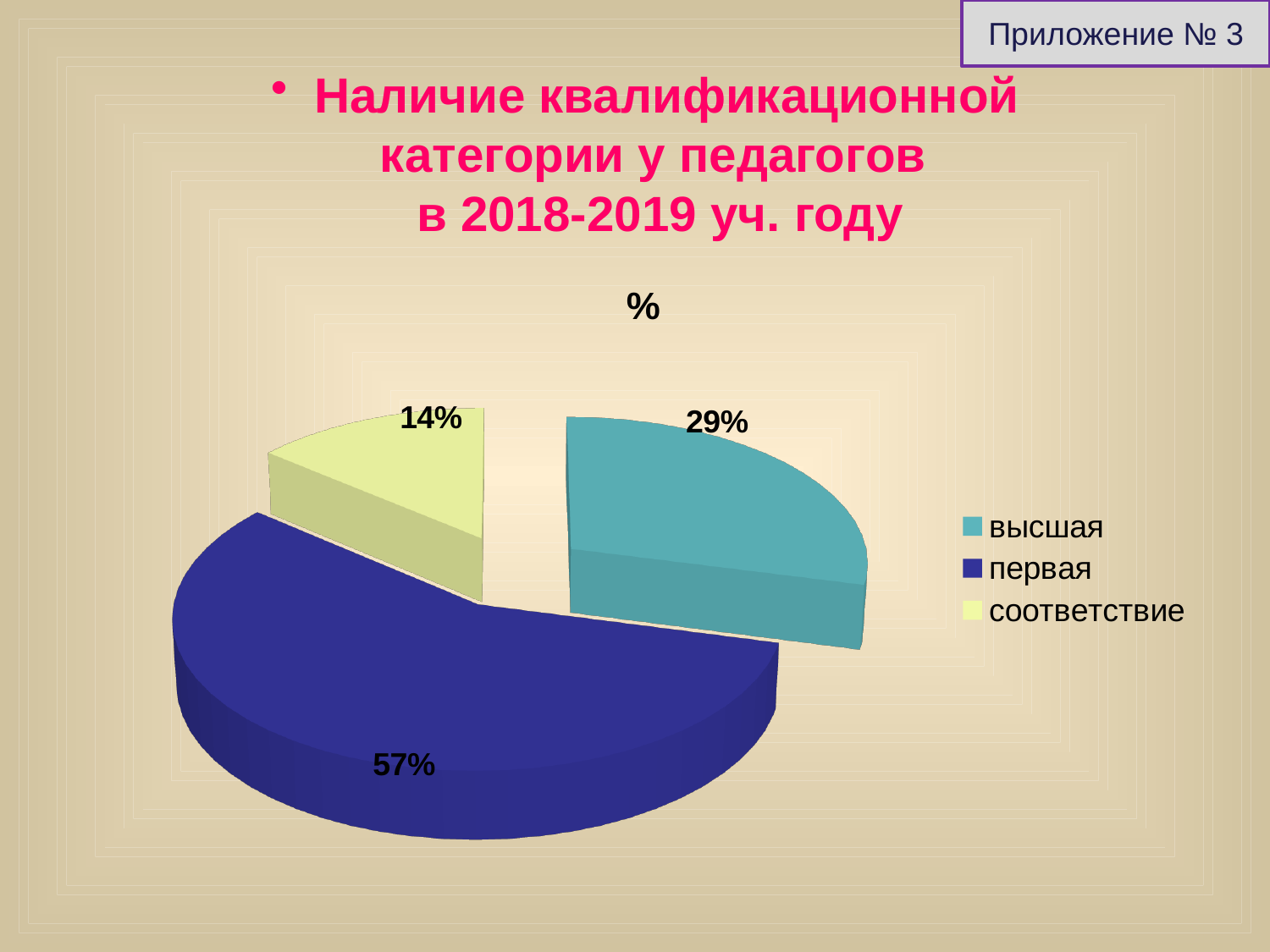
What share of the pie does the 'высшая' category have? 29% Which is larger, the share for 'высшая' or the share for 'соответствие'? высшая What is the difference in percentage points between 'высшая' and 'соответствие'? 15 What is the difference in percentage points between 'первая' and 'высшая'? 28 What kind of chart is shown on the slide? pie chart Which category has the largest share of the pie? первая How many entries does the legend list? 3 What colour is the slice for 'первая'? dark blue What share of the pie does the 'первая' category have? 57% Which category has the smallest share of the pie? соответствие What share of the pie does the 'соответствие' category have? 14% How many categories does the pie chart have? 3